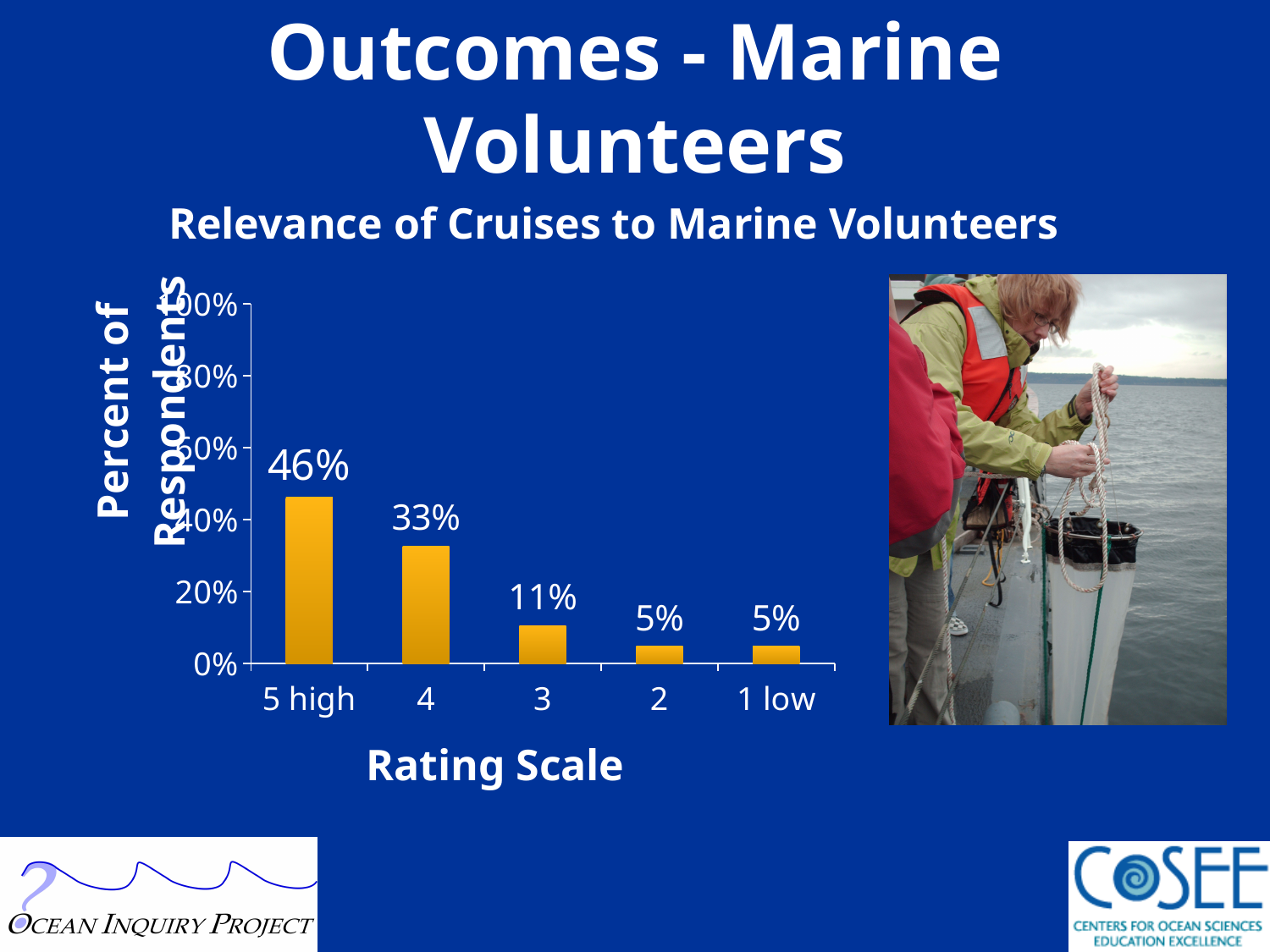
What is the title of the chart? Relevance of Cruises to Marine Volunteers How many rating categories are shown on the x axis? 5 What percent of respondents gave a rating of 3? 11% Which has a larger percent of respondents, rating 3 or rating 2? 3 What percent of respondents gave a rating of 1 low? 5% What kind of chart is shown on the slide? bar chart What is the difference in percent of respondents between rating 4 and rating 3? 22% Which rating received the highest percent of respondents? 5 high What percent of respondents gave a rating of 4? 33% What percent of respondents gave a rating of 5 high? 46% Is the value for rating 5 high greater or less than 40%? greater What is the difference in percent of respondents between rating 5 high and rating 4? 13%